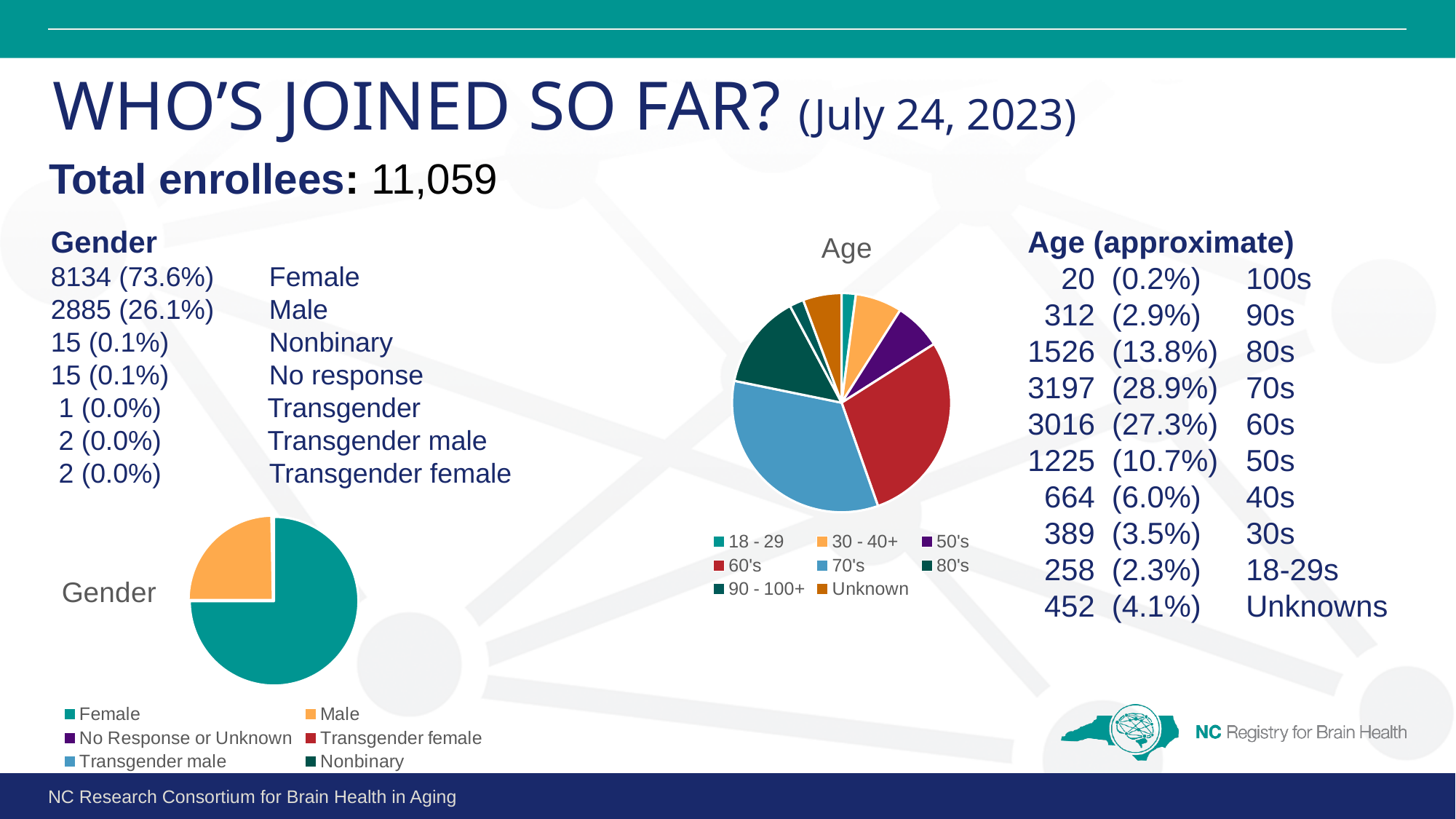
What kind of chart is the Gender chart on the left? pie chart How many categories does the legend of the Age pie chart list? 8 In the Age pie chart, which slice is larger: 60's or 80's? 60's How many categories does the legend of the Gender pie chart list? 6 In the Age pie chart, which age group has the largest slice? 70's In the Age pie chart, what is the difference between the number of enrollees in their 70s and in their 60s? 181 In the Gender pie chart, what share of enrollees is Female? 73.6% In the Gender pie chart, which category has the largest slice? Female In the Age pie chart, what share of enrollees is in their 70s? 28.9% In the Age pie chart, how many enrollees are in their 60s? 3016 In the Gender pie chart, how many enrollees are Male? 2885 What is the title of the pie chart in the middle of the slide? Age